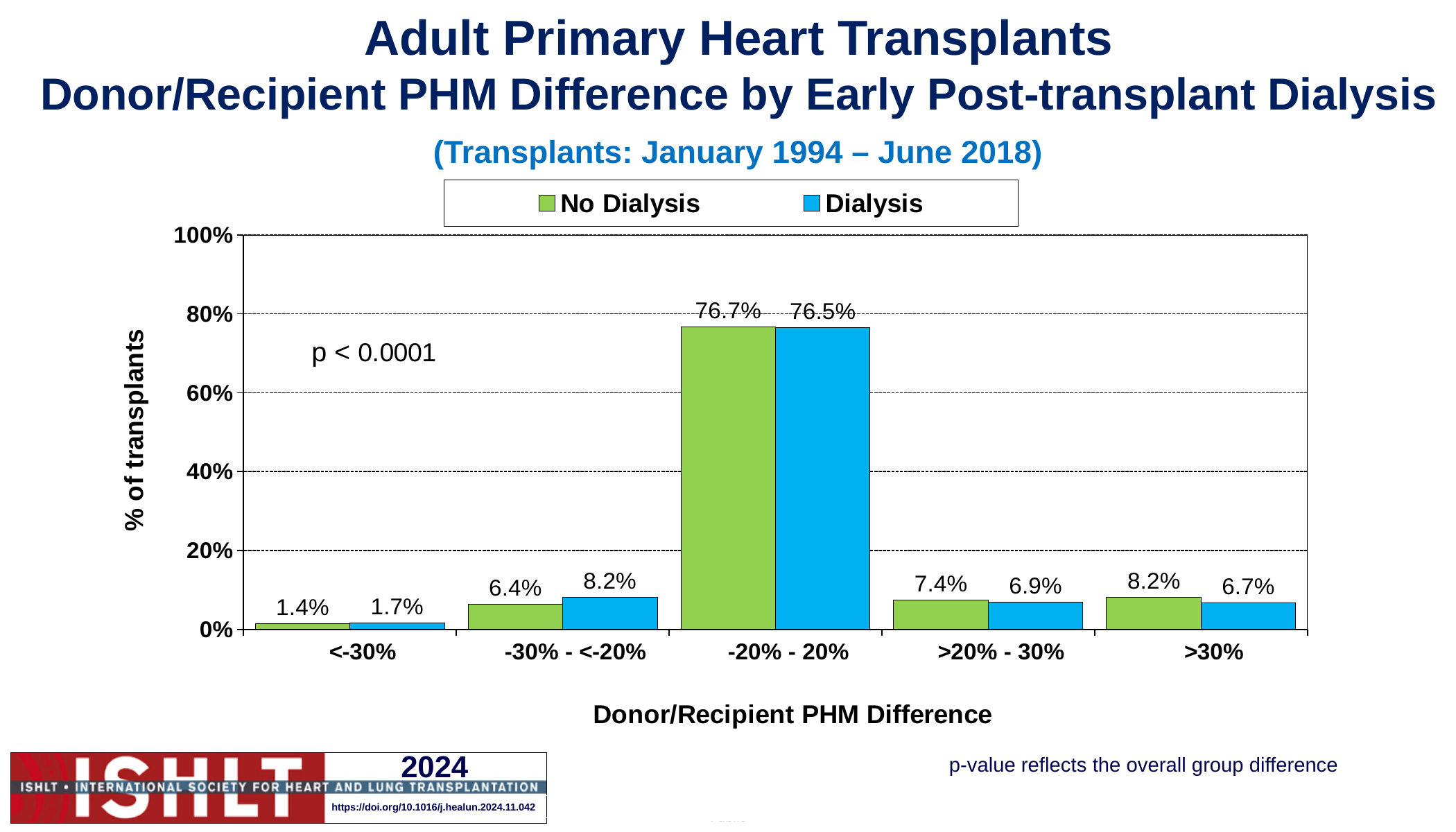
Which category has the lowest value for the Dialysis group? <-30% What is the value for the Dialysis group in the -30% - <-20% category? 8.2% In the >30% category, which group has the larger value, No Dialysis or Dialysis? No Dialysis What is the difference between the No Dialysis and Dialysis values in the >20% - 30% category? 0.5% Which Donor/Recipient PHM Difference category has the highest value for the No Dialysis group? -20% - 20% What percentage of transplants in the No Dialysis group had a Donor/Recipient PHM Difference of -20% - 20%? 76.7% How many Donor/Recipient PHM Difference categories are shown on the x axis? 5 What p-value is shown on the chart? p < 0.0001 What is the value for the Dialysis group in the >30% category? 6.7% Is the No Dialysis value for the -20% - 20% category greater or less than 60%? greater How many series does the legend list? 2 What kind of chart is shown on the slide? Bar chart